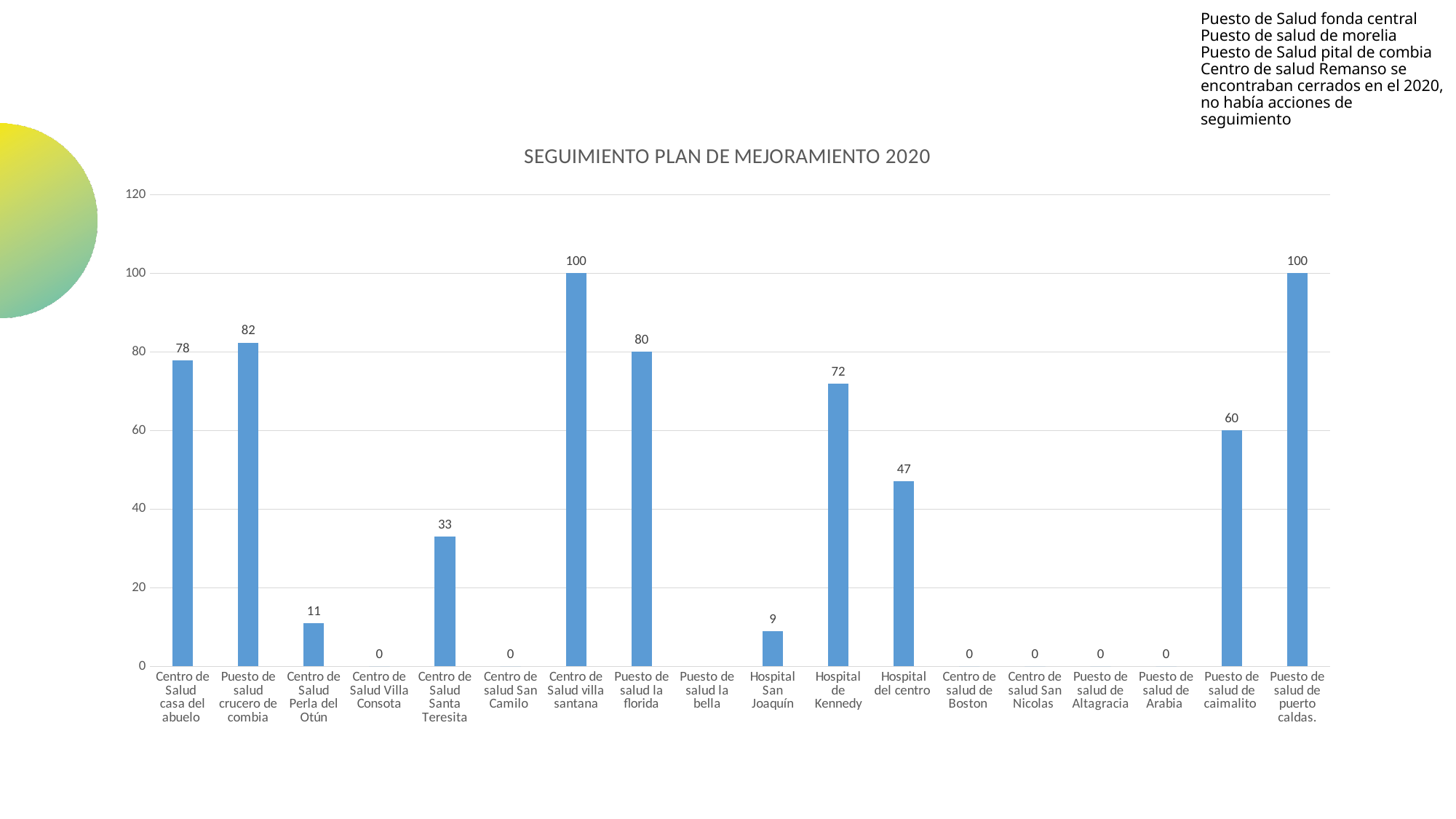
Which has a higher value, Hospital de Kennedy or Hospital del centro? Hospital de Kennedy What is the title of the chart? SEGUIMIENTO PLAN DE MEJORAMIENTO 2020 How many categories are shown on the x axis? 18 What is the value for Centro de Salud Santa Teresita? 33 What is the value for Centro de Salud Perla del Otún? 11 Which has a higher value, Centro de Salud Perla del Otún or Hospital San Joaquín? Centro de Salud Perla del Otún What is the value for Hospital de Kennedy? 72 What is the difference between the values for Centro de Salud villa santana and Puesto de salud la florida? 20 What is the value for Puesto de salud de caimalito? 60 Which two categories share the highest value of 100? Centro de Salud villa santana and Puesto de salud de puerto caldas What is the value for Hospital del centro? 47 What is the difference between the values for Puesto de salud crucero de combia and Centro de Salud casa del abuelo? 4